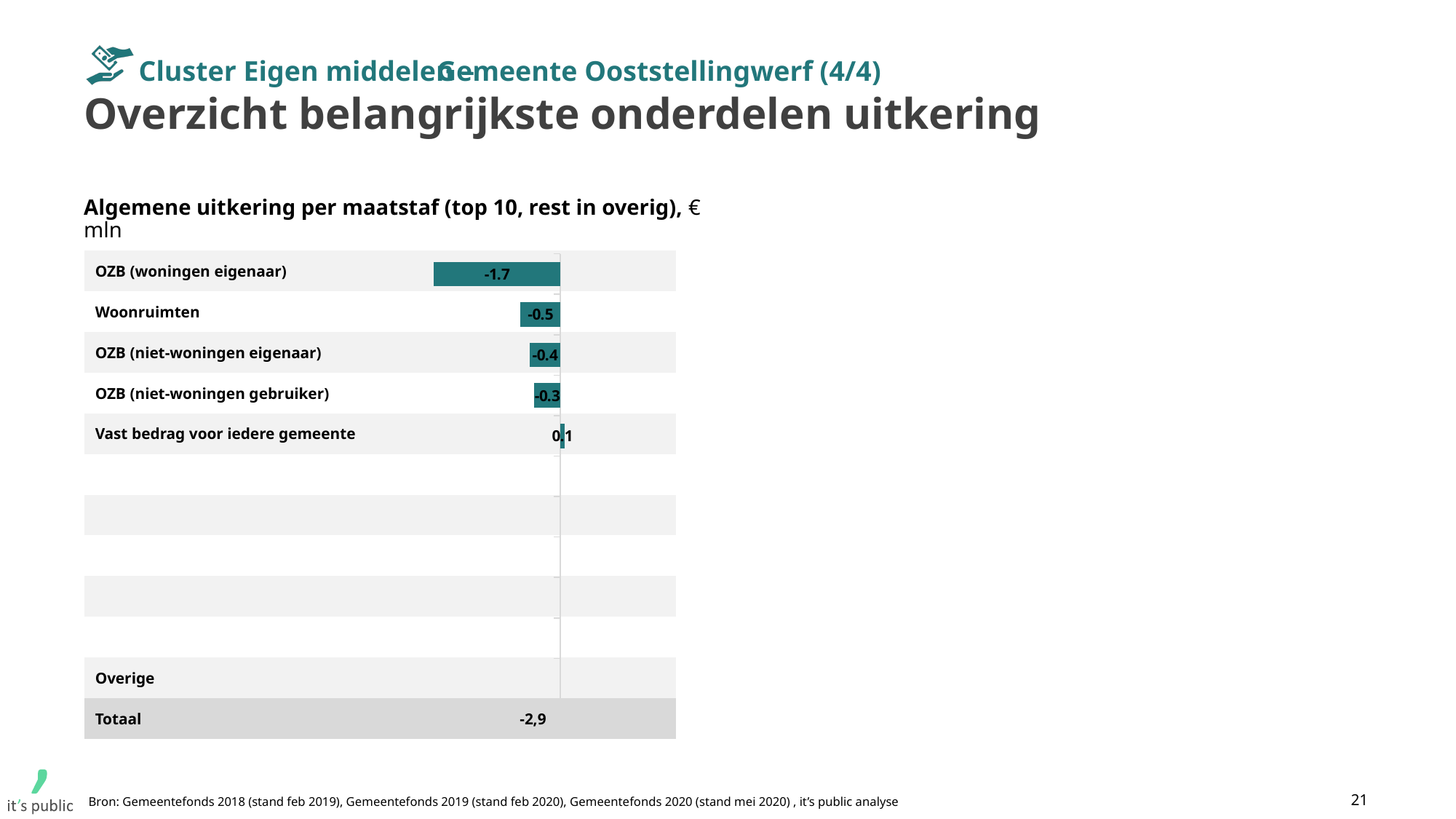
What is the difference between the values for OZB (woningen eigenaar) and Woonruimten? 1.2 What is the title of the chart? Algemene uitkering per maatstaf (top 10, rest in overig), € mln What is the value shown for Totaal? -2,9 How many categories have a plotted bar with a data label? 5 What is the value for Vast bedrag voor iedere gemeente? 0.1 What kind of chart is shown on the slide? Bar chart Which category has the highest value? Vast bedrag voor iedere gemeente Which category has the lowest (most negative) value? OZB (woningen eigenaar) What is the value for Woonruimten? -0.5 Which has the more negative value, Woonruimten or OZB (niet-woningen gebruiker)? Woonruimten What is the value for OZB (niet-woningen eigenaar)? -0.4 What is the value for OZB (woningen eigenaar)? -1.7